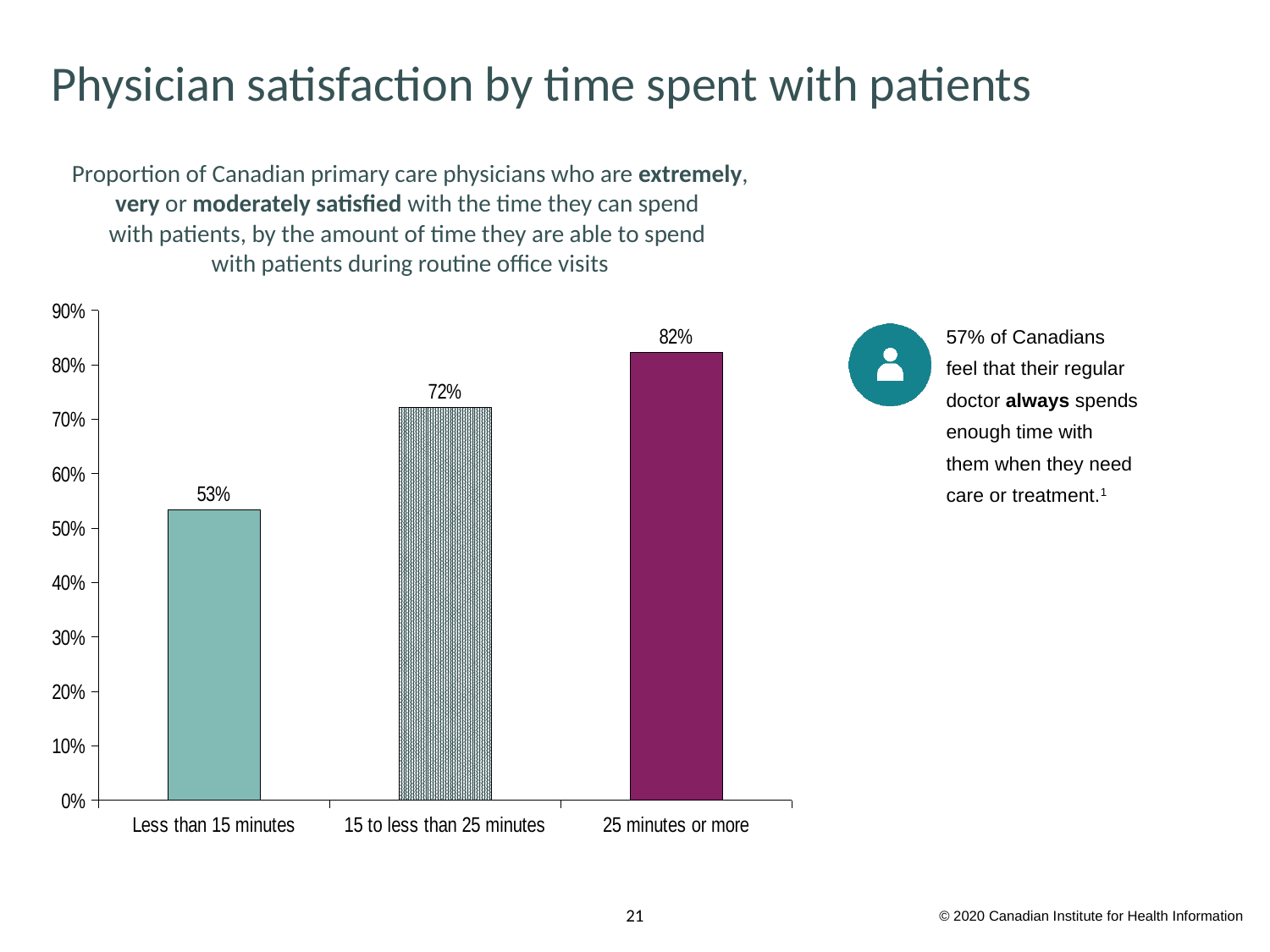
Do the values rise or fall from left to right along the x axis? rise How many categories are shown on the x axis? 3 What is the difference between the values for '15 to less than 25 minutes' and 'Less than 15 minutes'? 19% What kind of chart is shown on the slide? bar chart Which category has the highest value? 25 minutes or more What is the value for '15 to less than 25 minutes'? 72% Is the value for 'Less than 15 minutes' greater or less than 60%? less Which is larger, the value for '15 to less than 25 minutes' or the value for '25 minutes or more'? 25 minutes or more What is the difference between the values for '25 minutes or more' and 'Less than 15 minutes'? 29% What is the value for '25 minutes or more'? 82% Which category has the lowest value? Less than 15 minutes What is the value for 'Less than 15 minutes'? 53%